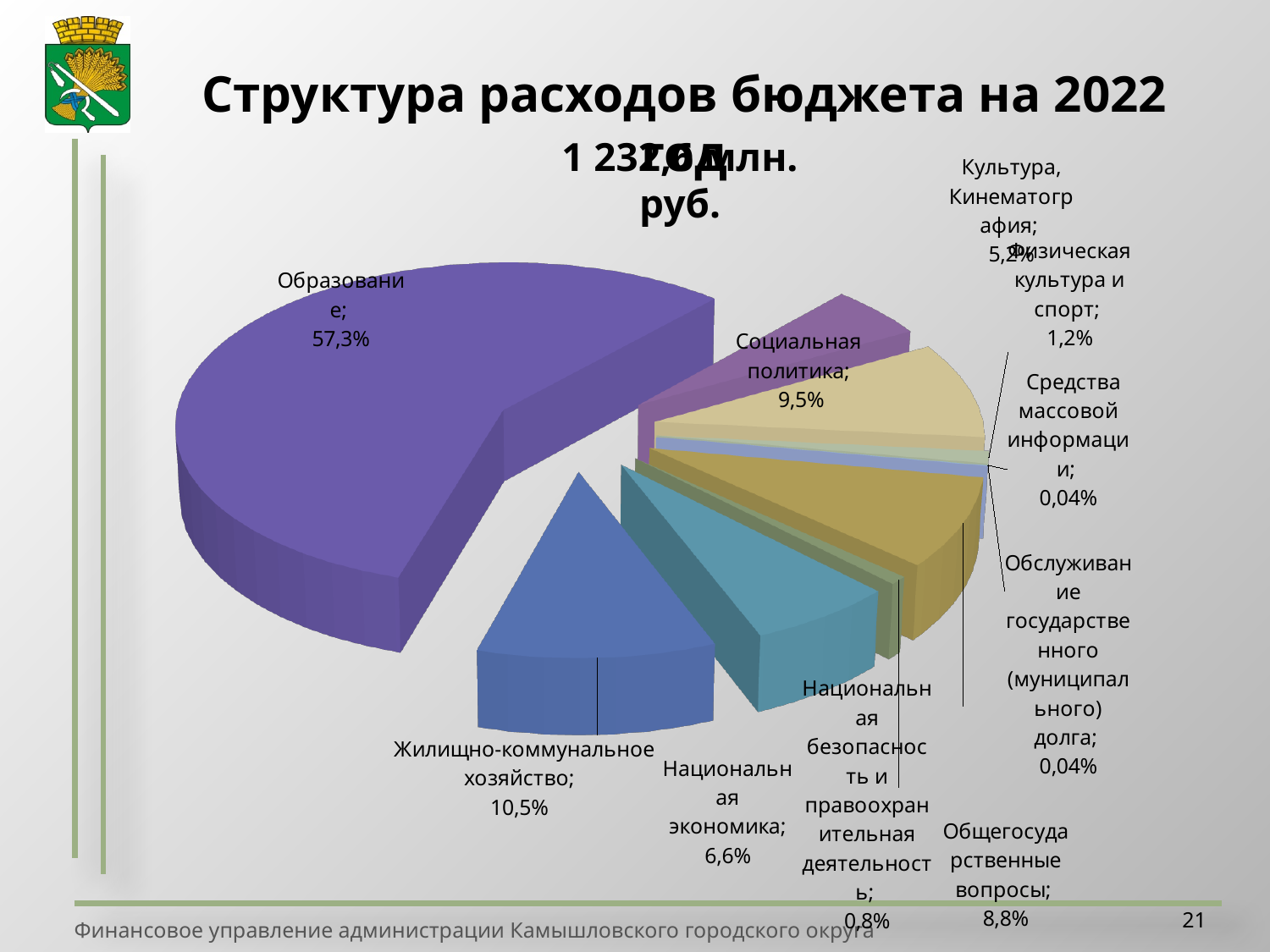
What is the value shown for Общегосударственные вопросы? 8,8% What is the value shown for Социальная политика? 9,5% What is the difference in percentage points between Образование and Жилищно-коммунальное хозяйство? 46,8 What is the value shown for Средства массовой информации? 0,04% What kind of chart is shown on the slide? pie chart What share of the 2022 budget expenditures goes to Образование? 57,3% Which category has the largest share of the pie? Образование How many categories (slices) does the pie chart have? 10 Which is larger: Жилищно-коммунальное хозяйство or Социальная политика? Жилищно-коммунальное хозяйство What is the value shown for Национальная экономика? 6,6% What is the value shown for Жилищно-коммунальное хозяйство? 10,5% What is the value shown for Культура, Кинематография? 5,2%